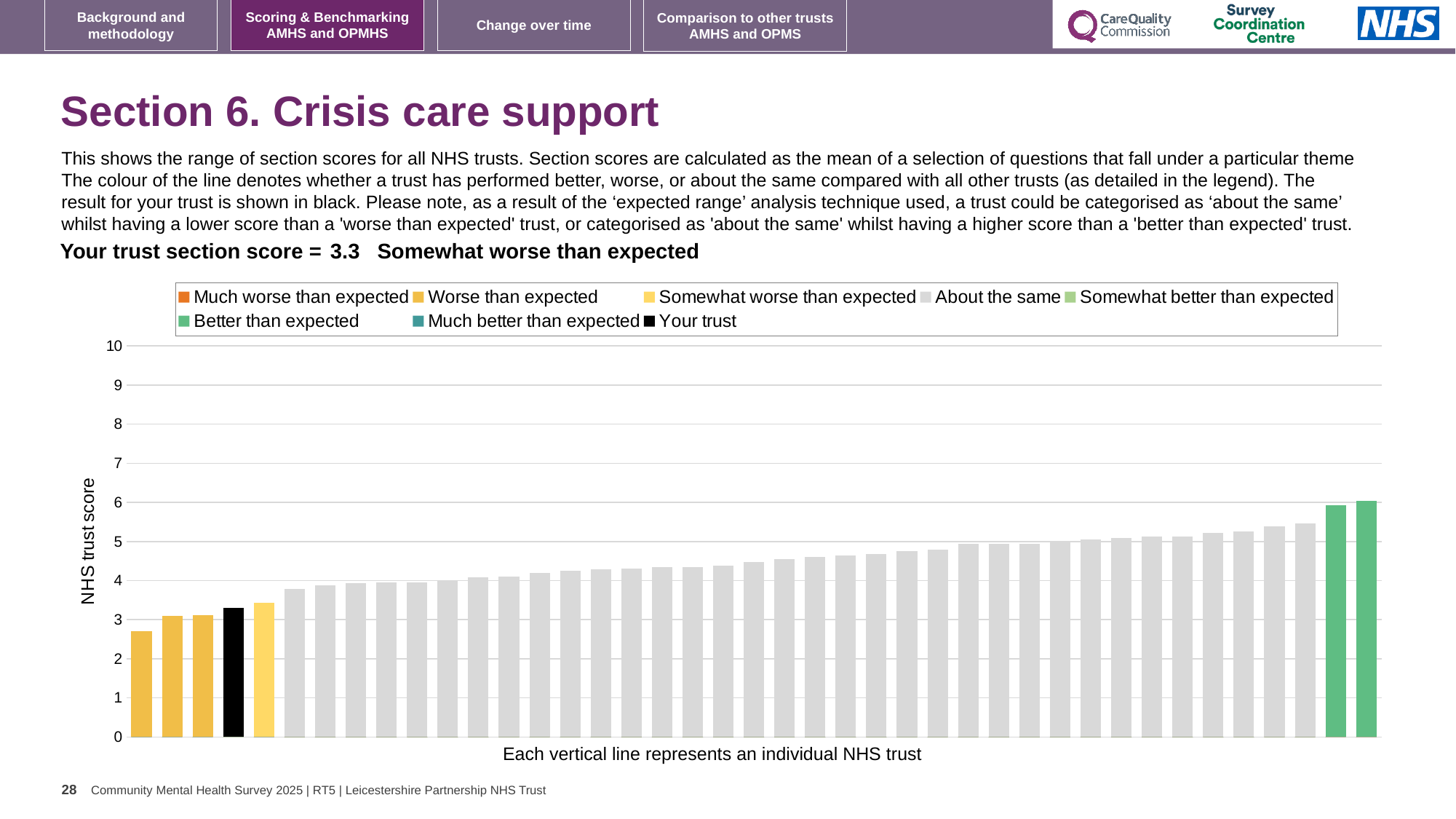
How many bars are coloured green (better than expected) in the chart? 2 What is the section score for your trust shown on the slide? 3.3 Do the bar values rise or fall from left to right along the x axis? Rise Is the value of the tallest bar in the chart greater or less than 5? greater Is the value of the black 'Your trust' bar greater or less than 4? less How is your trust's section score categorised according to the slide? Somewhat worse than expected What kind of chart is shown on the slide? Bar chart Which is larger: the black 'Your trust' bar or the leftmost bar? The black 'Your trust' bar How many entries does the chart legend list? 8 What is the highest tick value shown on the vertical axis? 10 Is the value of the leftmost (lowest) bar greater or less than 3? less What is the label on the vertical axis of the chart? NHS trust score